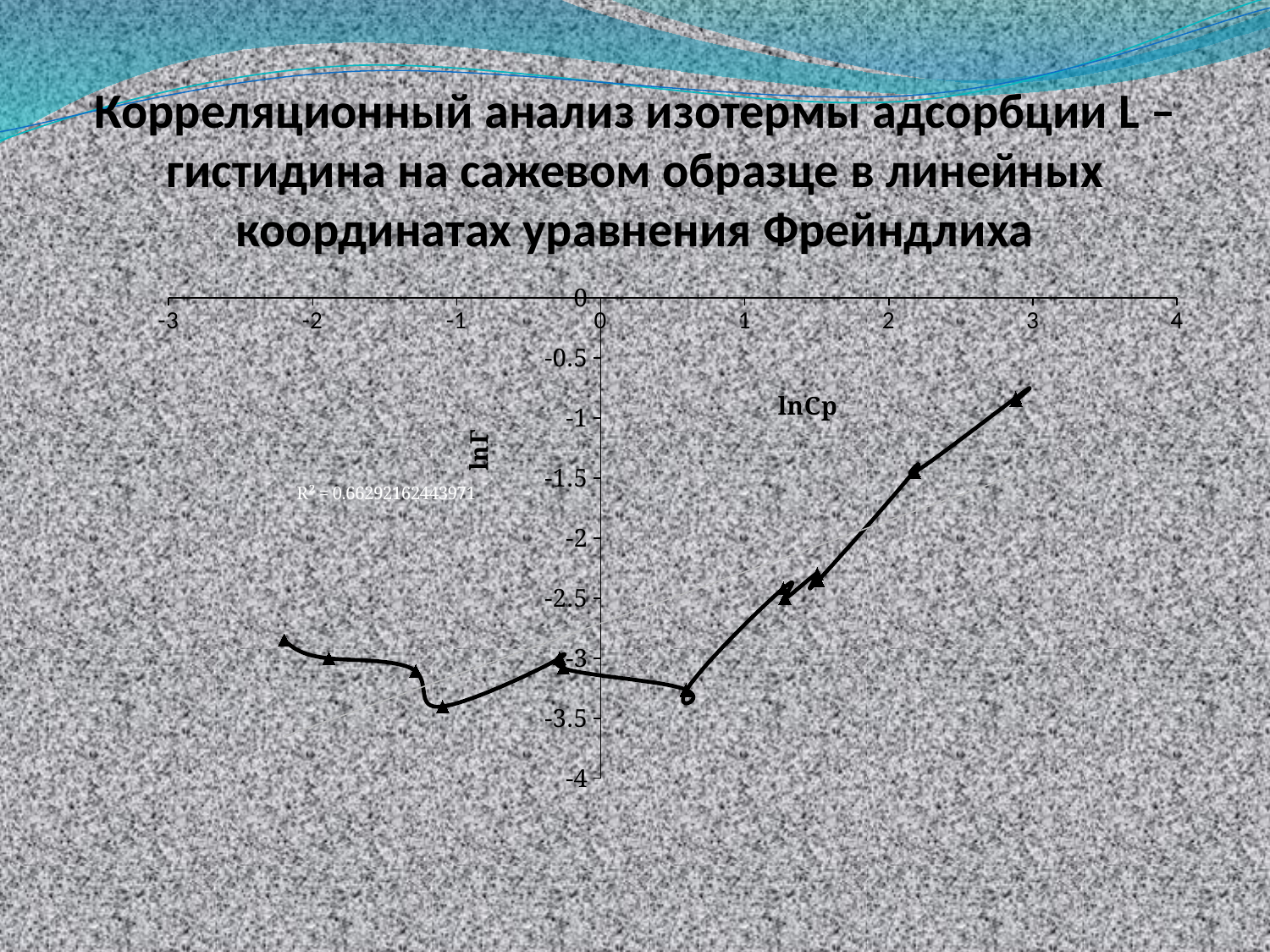
What R² value is printed on the chart? R² = 0.66292162443971 What is the label of the horizontal axis of the chart? lnCp Is the value of lnГ for the point at lnCp near 2.2 greater or less than -2? greater Do the lnГ values rise or fall as lnCp increases from about 0.6 to about 3? rise Is the value of lnГ for the rightmost point (lnCp near 3) greater or less than -1? greater Is the value of lnГ for the point at lnCp near -1.1 greater or less than -3? less Which point has the highest lnГ value: the one at lnCp near 3 or the one at lnCp near -2.2? the one at lnCp near 3 What is the lowest value shown on the vertical axis of the chart? -4 What kind of chart is shown on the slide? line chart (scatter with smoothed lines)